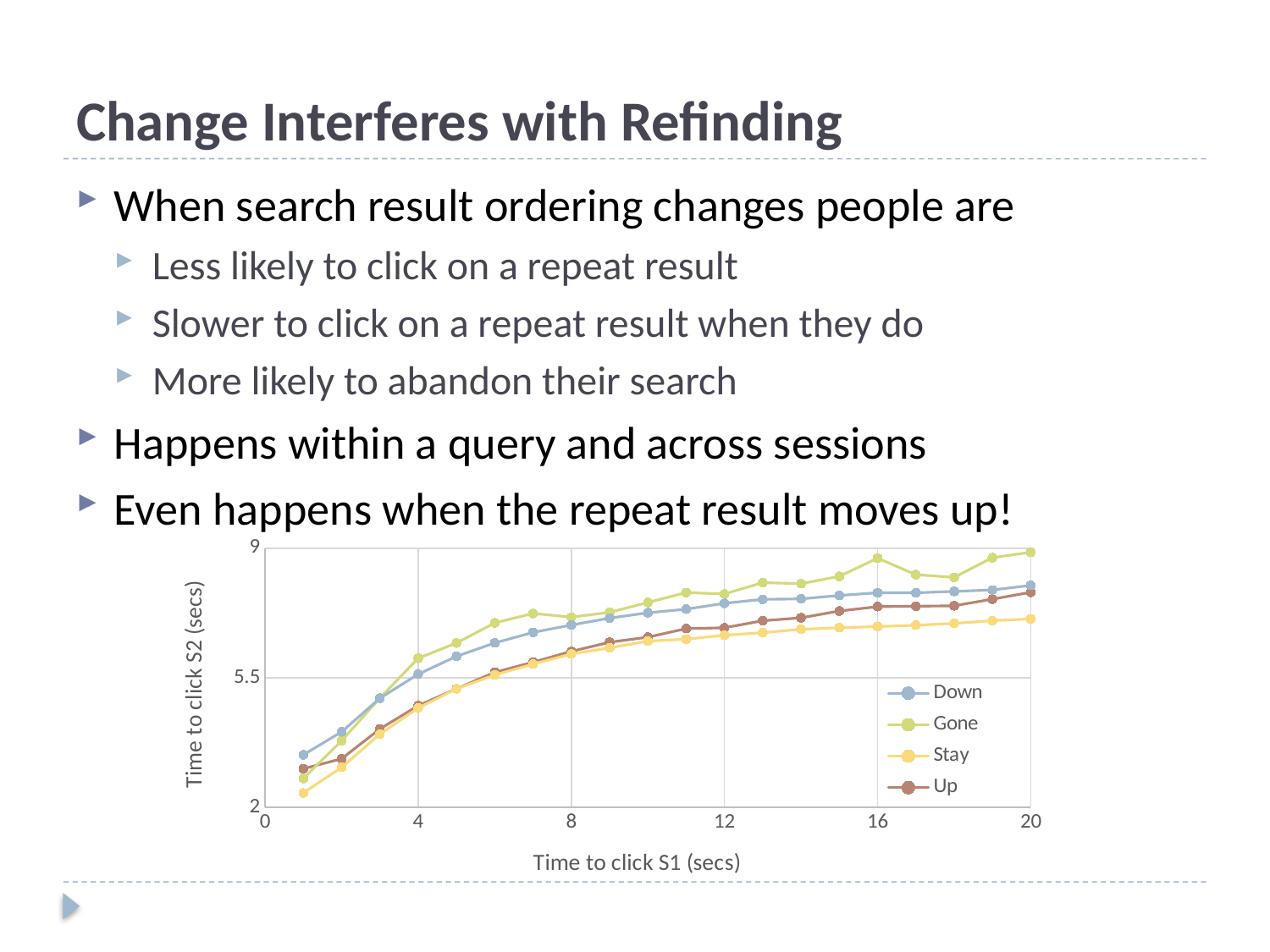
Do the values of the Gone series generally rise or fall as Time to click S1 increases? rise At Time to click S1 = 1 sec, which series has the larger value, Down or Stay? Down What is the title of the chart's x axis? Time to click S1 (secs) What kind of chart is shown on the slide? line chart Which series has the lowest value at Time to click S1 = 20 secs? Stay How many series does the chart's legend list? 4 What are the series names listed in the chart's legend? Down, Gone, Stay, Up Which series has the highest value at Time to click S1 = 20 secs? Gone Is the value for the Up series at Time to click S1 = 12 secs greater or less than 5.5? greater Is the value for the Stay series at Time to click S1 = 20 secs greater or less than 5.5? greater At Time to click S1 = 16 secs, which series has the larger value, Gone or Up? Gone Is the value for the Stay series at Time to click S1 = 2 secs greater or less than 5.5? less